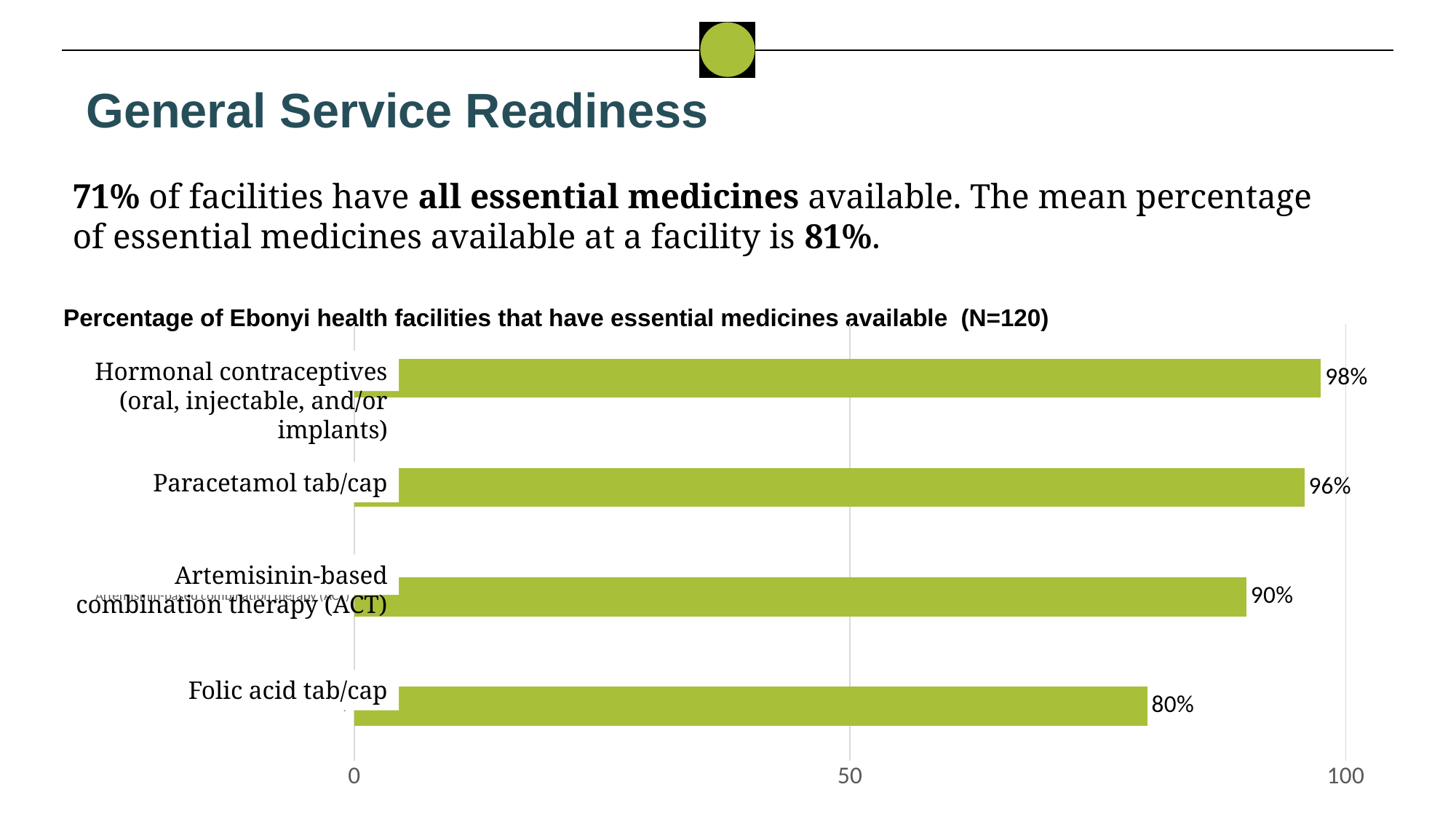
How many essential medicines are shown in the chart? 4 What is the difference in percentage points between hormonal contraceptives and Folic acid tab/cap availability? 18 What percentage of facilities have hormonal contraceptives (oral, injectable, and/or implants) available? 98% Which essential medicine is available at the lowest percentage of facilities? Folic acid tab/cap Which is available at more facilities, Paracetamol tab/cap or Artemisinin-based combination therapy (ACT)? Paracetamol tab/cap Is the value for Folic acid tab/cap greater or less than 50? greater What percentage of facilities have Artemisinin-based combination therapy (ACT) available? 90% What percentage of facilities have Paracetamol tab/cap available? 96% Which essential medicine is available at the highest percentage of facilities? Hormonal contraceptives (oral, injectable, and/or implants) What percentage of facilities have Folic acid tab/cap available? 80% What kind of chart is shown on the slide? Bar chart What is the sample size (N) stated in the chart title? 120